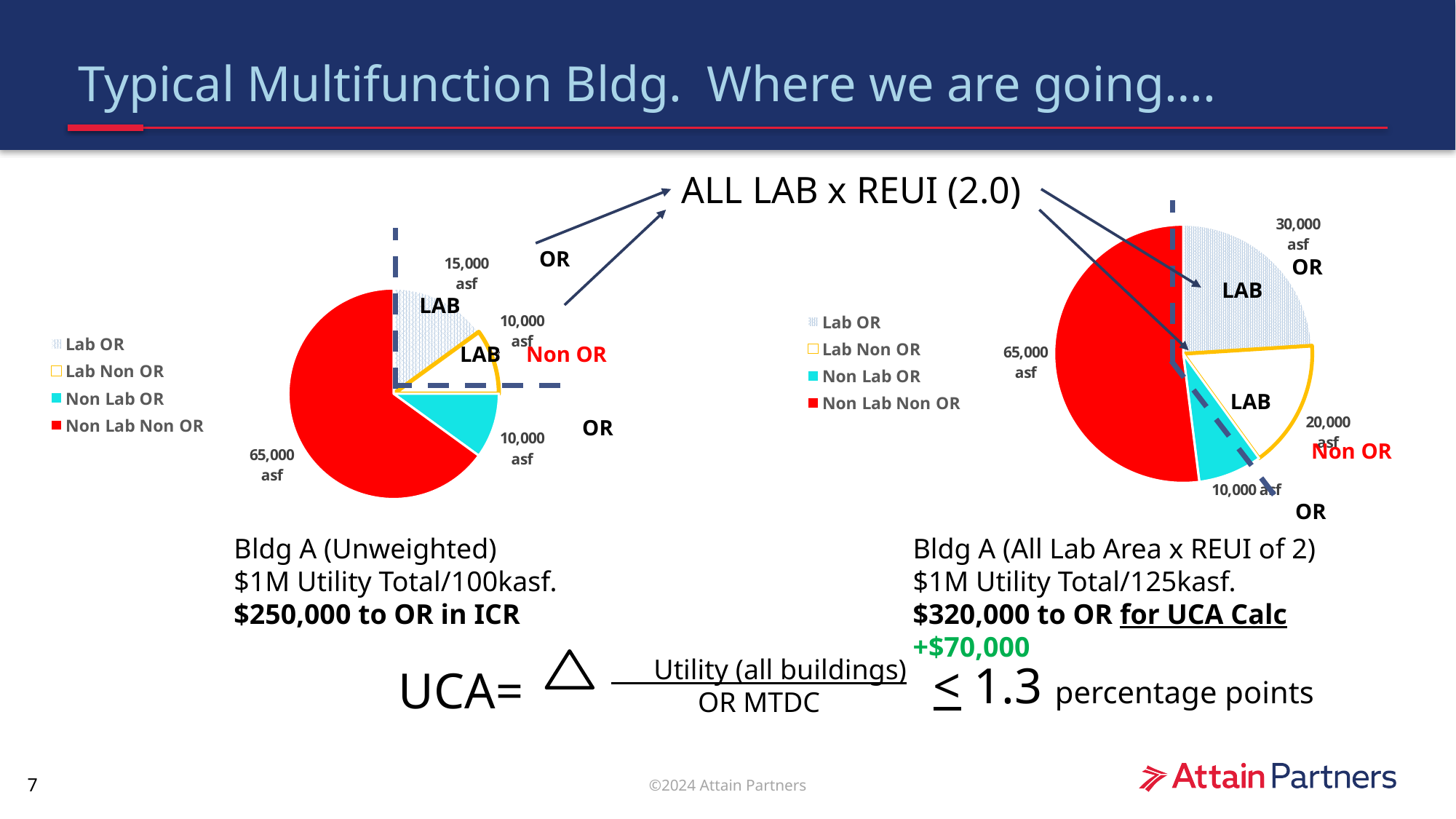
On the left pie chart (Bldg A Unweighted), which category has the largest slice? Non Lab Non OR What is the difference between the Lab OR value on the right pie chart and the Lab OR value on the left pie chart? 15,000 asf On the left pie chart (Bldg A Unweighted), what is the value for Lab OR? 15,000 asf On the left pie chart (Bldg A Unweighted), what share of the total does Non Lab Non OR represent? 65% What type of chart is used on the left side of the slide for Bldg A (Unweighted)? Pie chart On the right pie chart (Bldg A All Lab Area x REUI of 2), which category has the smallest slice? Non Lab OR On the right pie chart (Bldg A All Lab Area x REUI of 2), what is the value for Lab Non OR? 20,000 asf On the left pie chart (Bldg A Unweighted), what is the value for Non Lab Non OR? 65,000 asf On the right pie chart (Bldg A All Lab Area x REUI of 2), which is larger: Lab OR or Lab Non OR? Lab OR On the right pie chart (Bldg A All Lab Area x REUI of 2), what is the value for Lab OR? 30,000 asf How many series does the legend of the left pie chart list? 4 On the right pie chart (Bldg A All Lab Area x REUI of 2), what share of the total does Non Lab Non OR represent? 52%